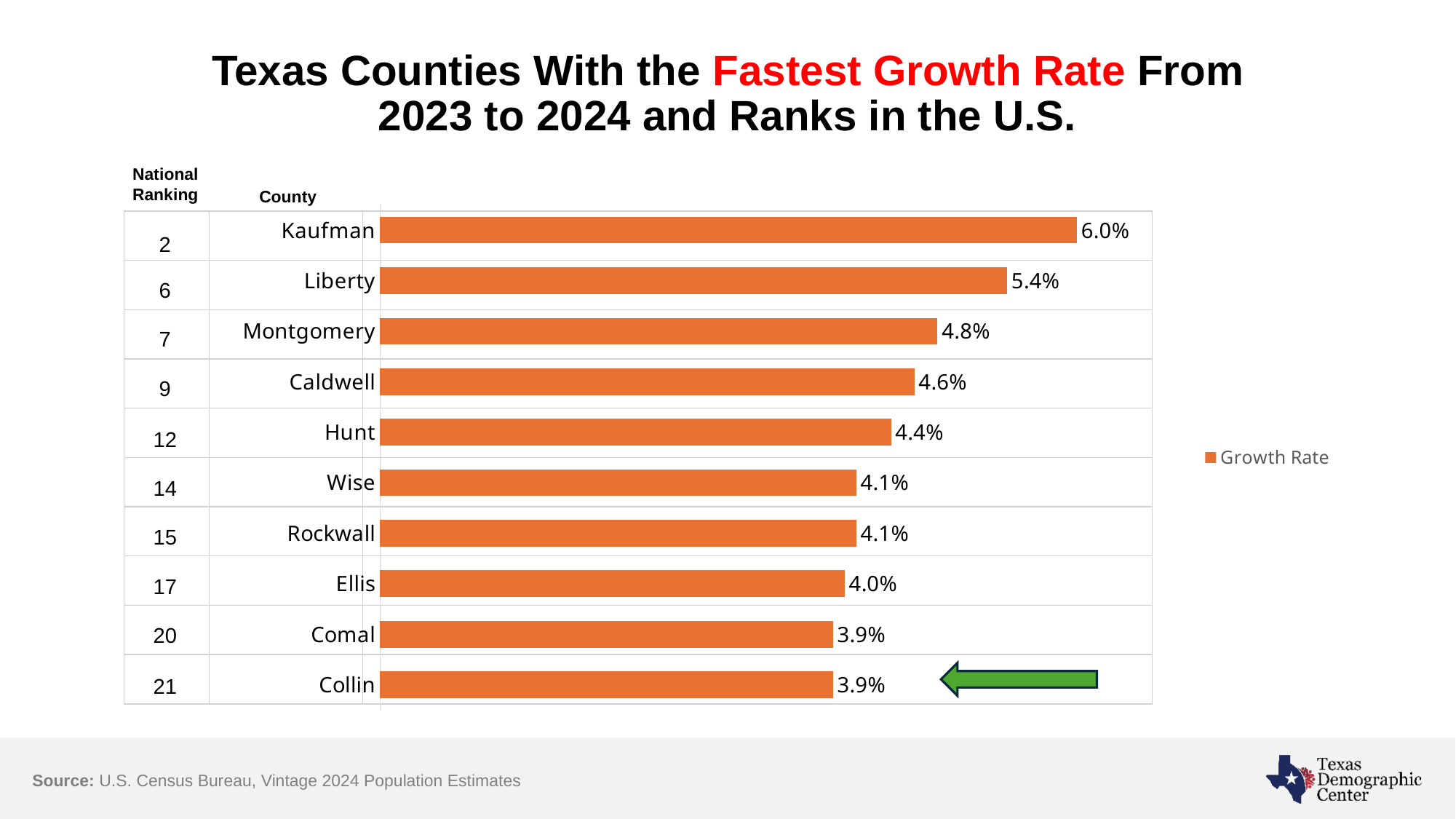
Which has a higher growth rate, Liberty or Caldwell? Liberty What is the growth rate for Hunt County? 4.4% What is the difference in growth rate between Caldwell and Ellis? 0.6% Which has a higher growth rate, Hunt or Comal? Hunt What is the difference in growth rate between Kaufman and Liberty? 0.6% What is the national ranking of Collin County? 21 How many counties are shown in the chart? 10 What is the growth rate for Montgomery County? 4.8% Which county has the highest growth rate? Kaufman How many series does the legend list? 1 What is the growth rate for Kaufman County? 6.0% What kind of chart is shown on the slide? Bar chart